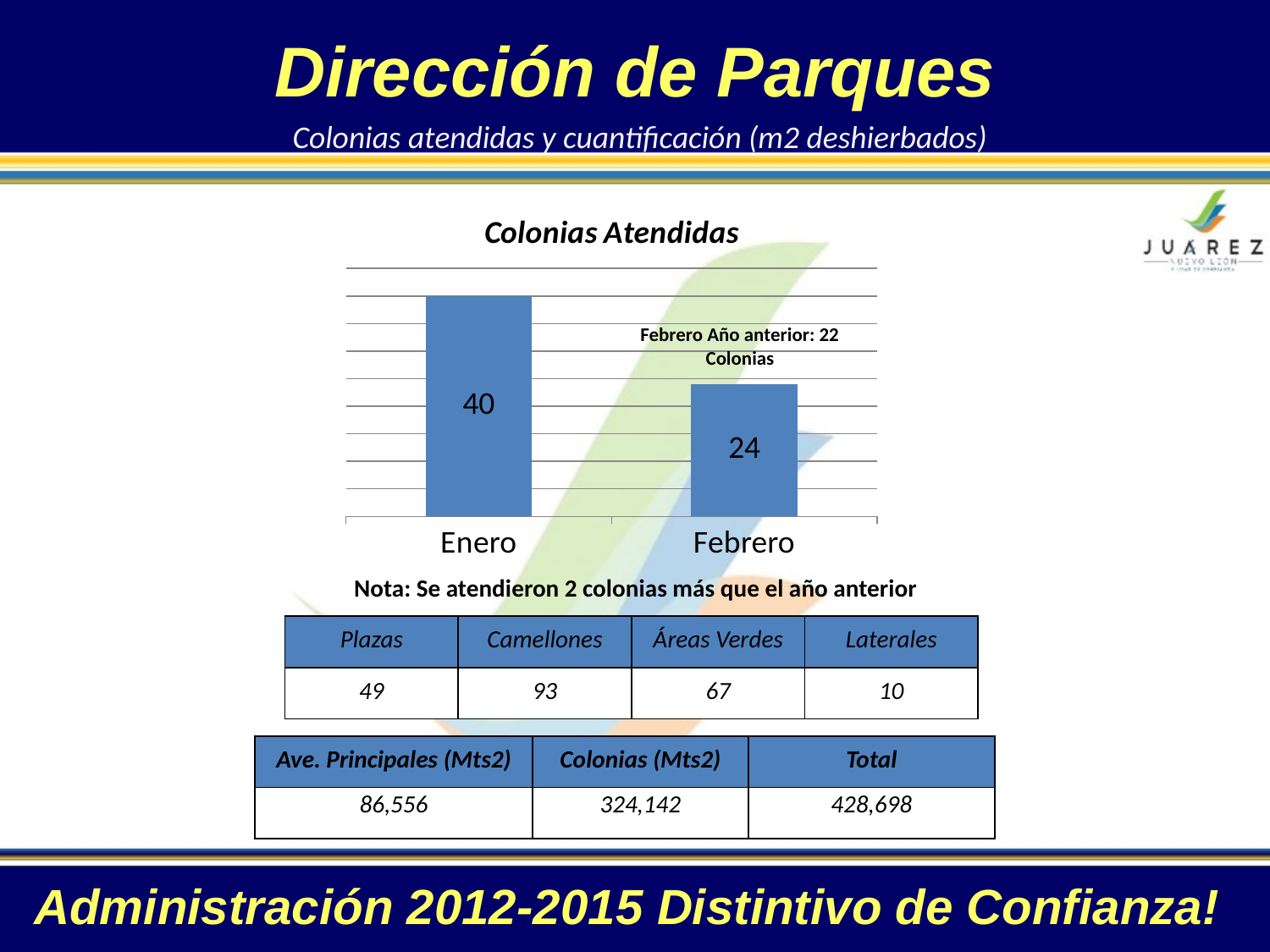
According to the annotation on the chart, how many colonias were attended in Febrero of the previous year? 22 Which month has the lowest value in the Colonias Atendidas chart? Febrero Which month has the highest value in the Colonias Atendidas chart? Enero What kind of chart is the Colonias Atendidas chart? Bar chart What is the value for Enero in the Colonias Atendidas chart? 40 What is the difference between the Enero and Febrero values in the Colonias Atendidas chart? 16 Do the values rise or fall from Enero to Febrero in the Colonias Atendidas chart? Fall In the Colonias Atendidas chart, is the value for Enero or Febrero larger? Enero What is the title of the chart on the slide? Colonias Atendidas How many categories are shown on the x axis of the Colonias Atendidas chart? 2 What is the value for Febrero in the Colonias Atendidas chart? 24